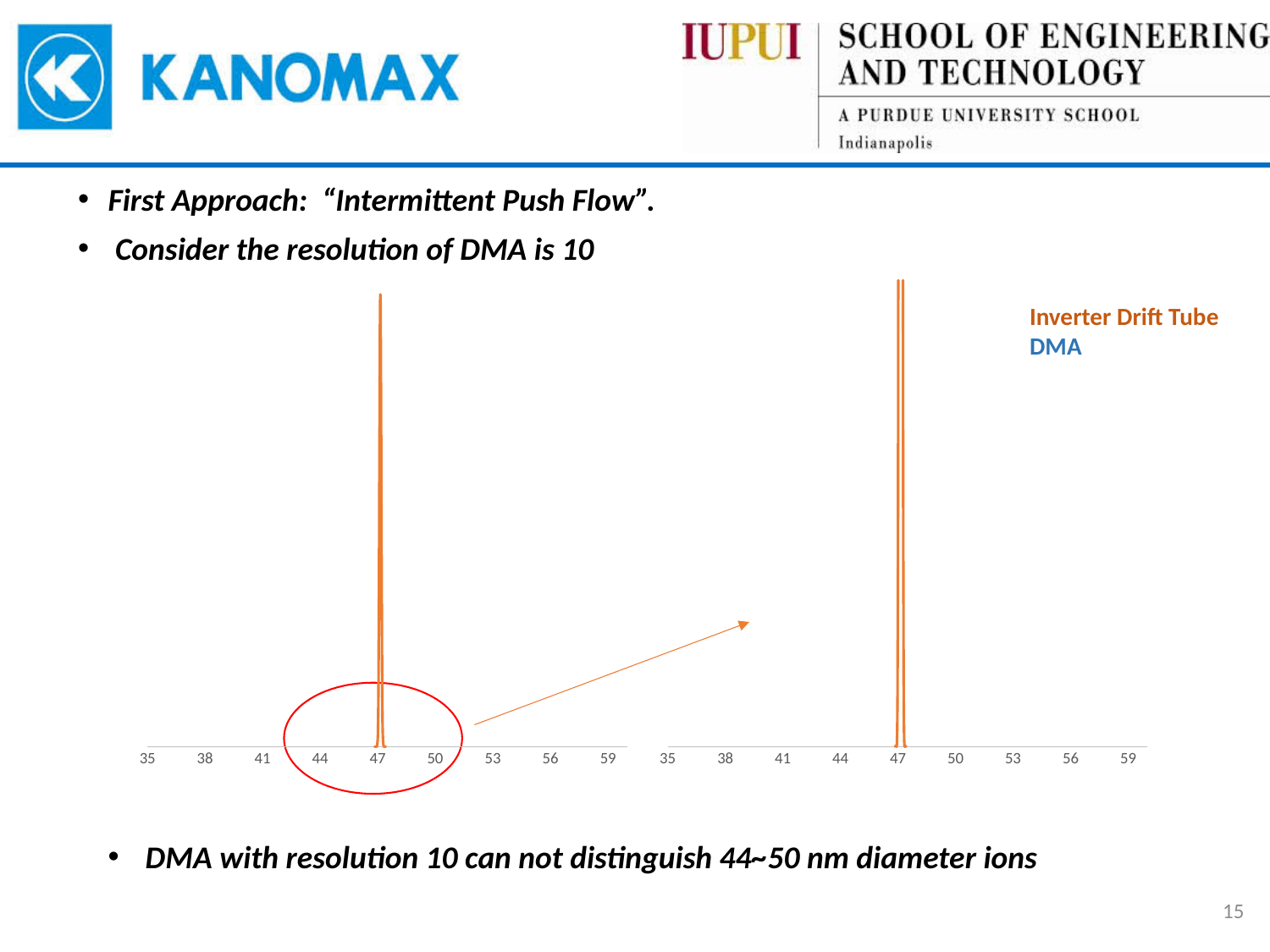
In the left chart, what is the first (leftmost) x-axis tick label? 35 In the left chart, does the peak of the line fall between the x-axis ticks 44 and 50? yes What kind of chart is the left chart on the slide? line chart In the right chart, how many tick labels are shown on the x axis? 9 In the left chart, what is the spacing between consecutive x-axis tick labels? 3 How many charts are shown on the slide? 2 What kind of chart is the right chart on the slide? line chart In the left chart, how many tick labels are shown on the x axis? 9 In the left chart, is the peak of the line closer to the x-axis tick 47 or to the tick 53? 47 In the right chart, is the peak of the line closer to the x-axis tick 47 or to the tick 41? 47